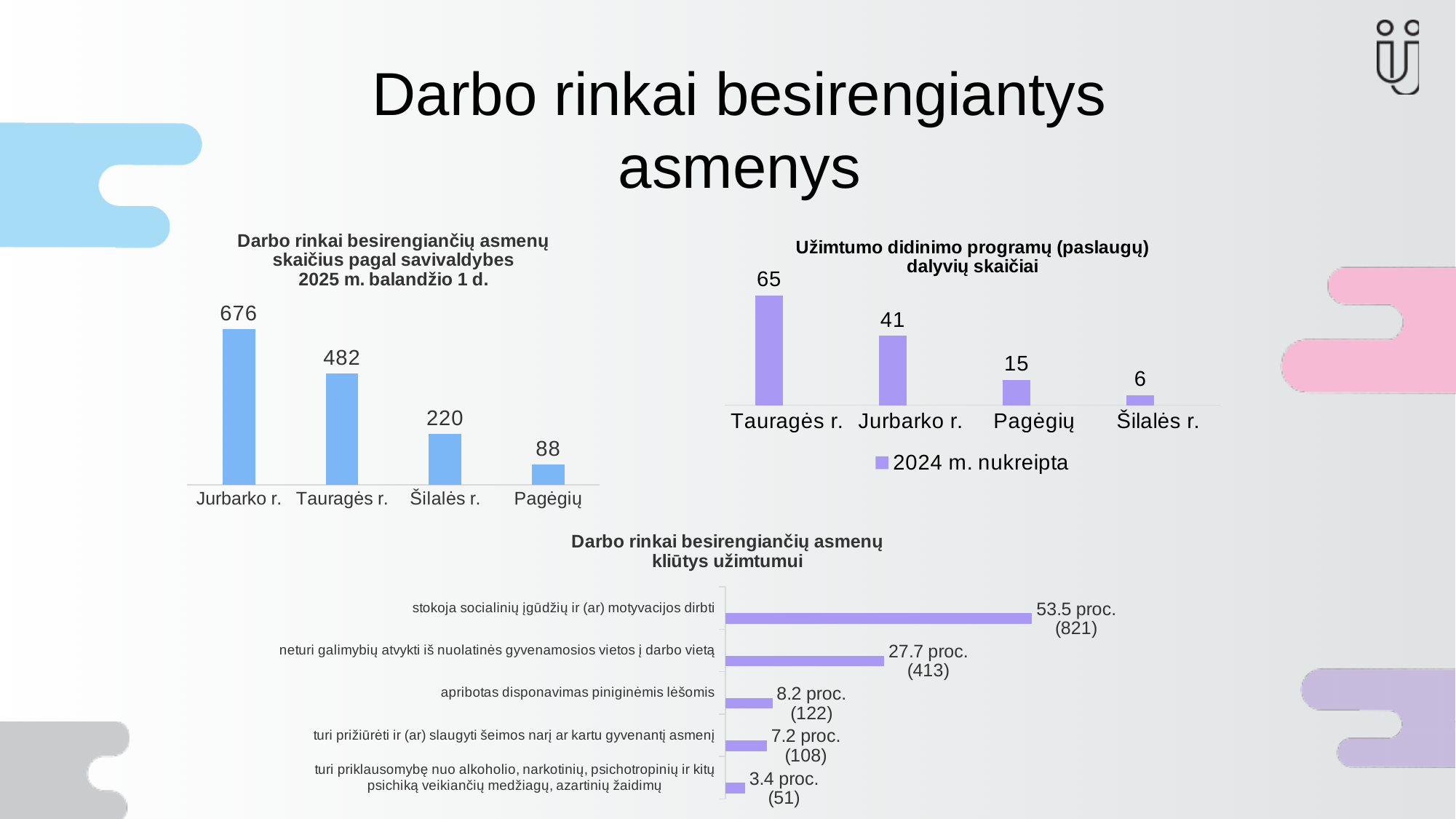
In the top-left chart (Darbo rinkai besirengiančių asmenų skaičius pagal savivaldybes), how many municipalities are shown? 4 In the top-left chart (Darbo rinkai besirengiančių asmenų skaičius pagal savivaldybes), which municipality has the lowest value? Pagėgių In the top-left chart (Darbo rinkai besirengiančių asmenų skaičius pagal savivaldybes), what is the value for Jurbarko r.? 676 In the top-right chart (Užimtumo didinimo programų (paslaugų) dalyvių skaičiai), do the values rise or fall from left to right? fall What type of chart is the bottom chart (Darbo rinkai besirengiančių asmenų kliūtys užimtumui)? bar chart In the top-left chart (Darbo rinkai besirengiančių asmenų skaičius pagal savivaldybes), what is the difference between Jurbarko r. and Tauragės r.? 194 In the top-right chart (Užimtumo didinimo programų (paslaugų) dalyvių skaičiai), which municipality has the highest value? Tauragės r. In the top-right chart (Užimtumo didinimo programų (paslaugų) dalyvių skaičiai), what series does the legend list? 2024 m. nukreipta In the top-right chart (Užimtumo didinimo programų (paslaugų) dalyvių skaičiai), what is the value for Pagėgių? 15 In the bottom chart (Darbo rinkai besirengiančių asmenų kliūtys užimtumui), what is the number in parentheses for 'stokoja socialinių įgūdžių ir (ar) motyvacijos dirbti'? 821 In the bottom chart (Darbo rinkai besirengiančių asmenų kliūtys užimtumui), what percentage is shown for 'neturi galimybių atvykti iš nuolatinės gyvenamosios vietos į darbo vietą'? 27.7 proc. In the top-right chart (Užimtumo didinimo programų (paslaugų) dalyvių skaičiai), which is larger: Jurbarko r. or Šilalės r.? Jurbarko r.